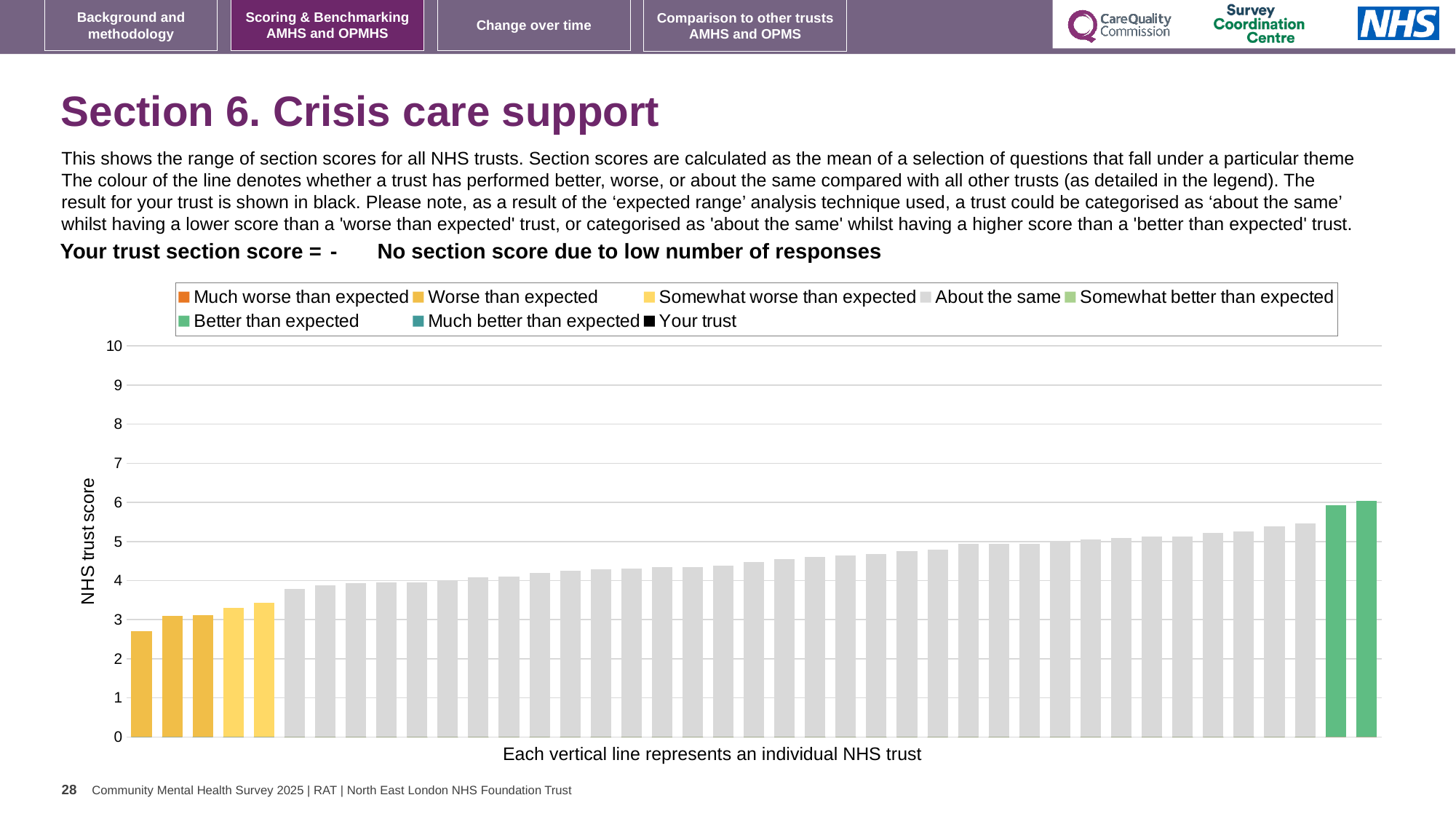
Is the value of the leftmost (lowest) bar greater or less than 3? less What is the title of the vertical axis? NHS trust score Do the bar values rise or fall from left to right across the chart? Rise Is the value of the rightmost (highest) bar greater or less than 5? greater What kind of chart is shown on the slide? Bar chart Is the value of the highest bar greater or less than 7? less What is the highest value shown on the vertical axis? 10 How many bars are coloured green (Better than expected)? 2 How many entries does the chart legend list? 8 According to the legend, what does the black colour represent? Your trust